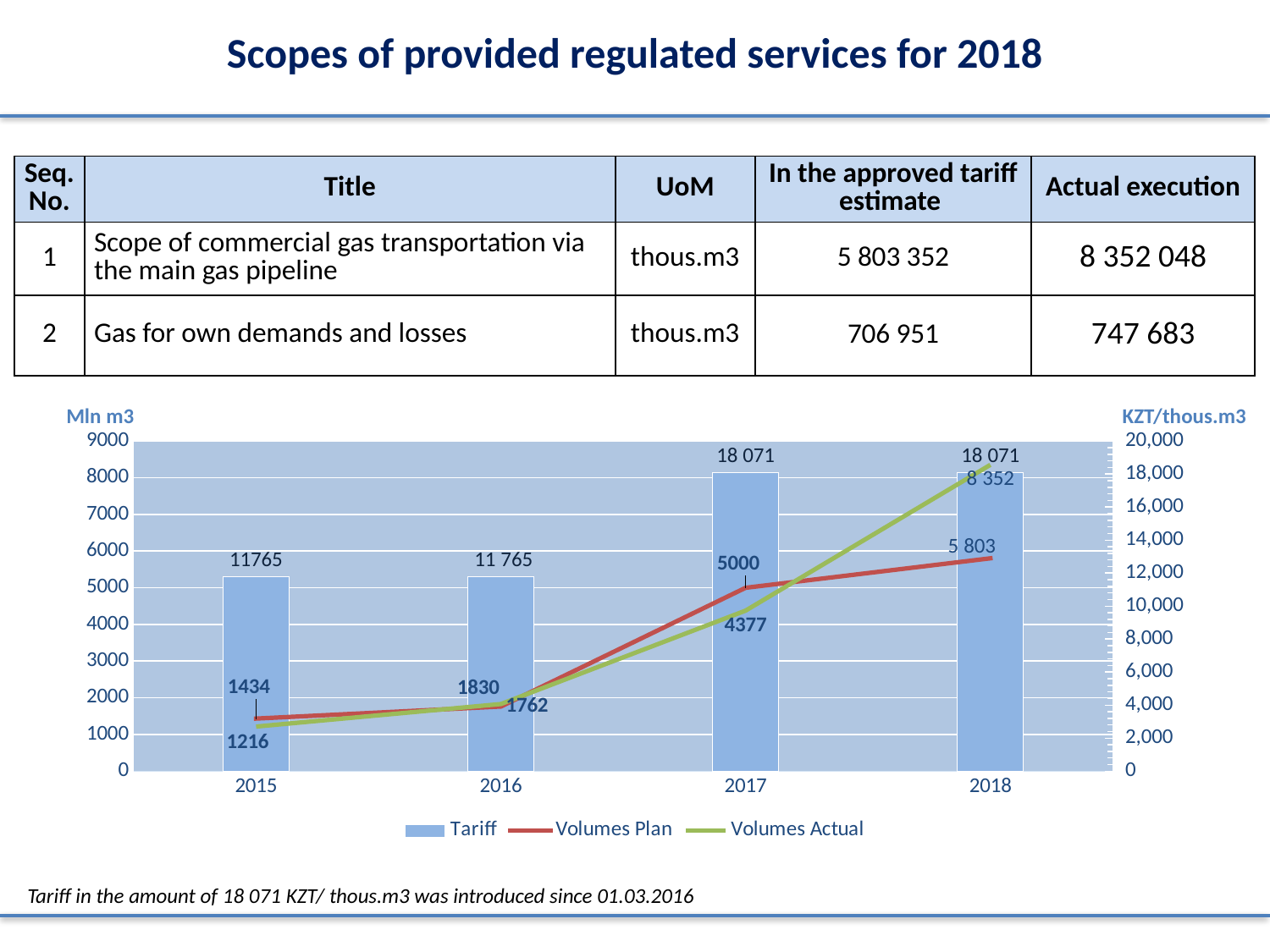
What is the Volumes Actual value for 2016? 1830 In which year is Volumes Plan the lowest? 2015 Does Volumes Actual rise or fall from 2015 to 2018? Rise How many series does the chart legend list? 3 What is the difference between Volumes Plan and Volumes Actual in 2017? 623 What is the Volumes Plan value for 2015? 1434 What is the Tariff value shown for 2017? 18 071 In which year is Volumes Actual the highest? 2018 In 2017, which is larger: Volumes Plan or Volumes Actual? Volumes Plan What is the Volumes Actual value for 2018? 8 352 How many years are shown on the x axis of the chart? 4 What kind of chart is shown on the slide? Combination bar and line chart